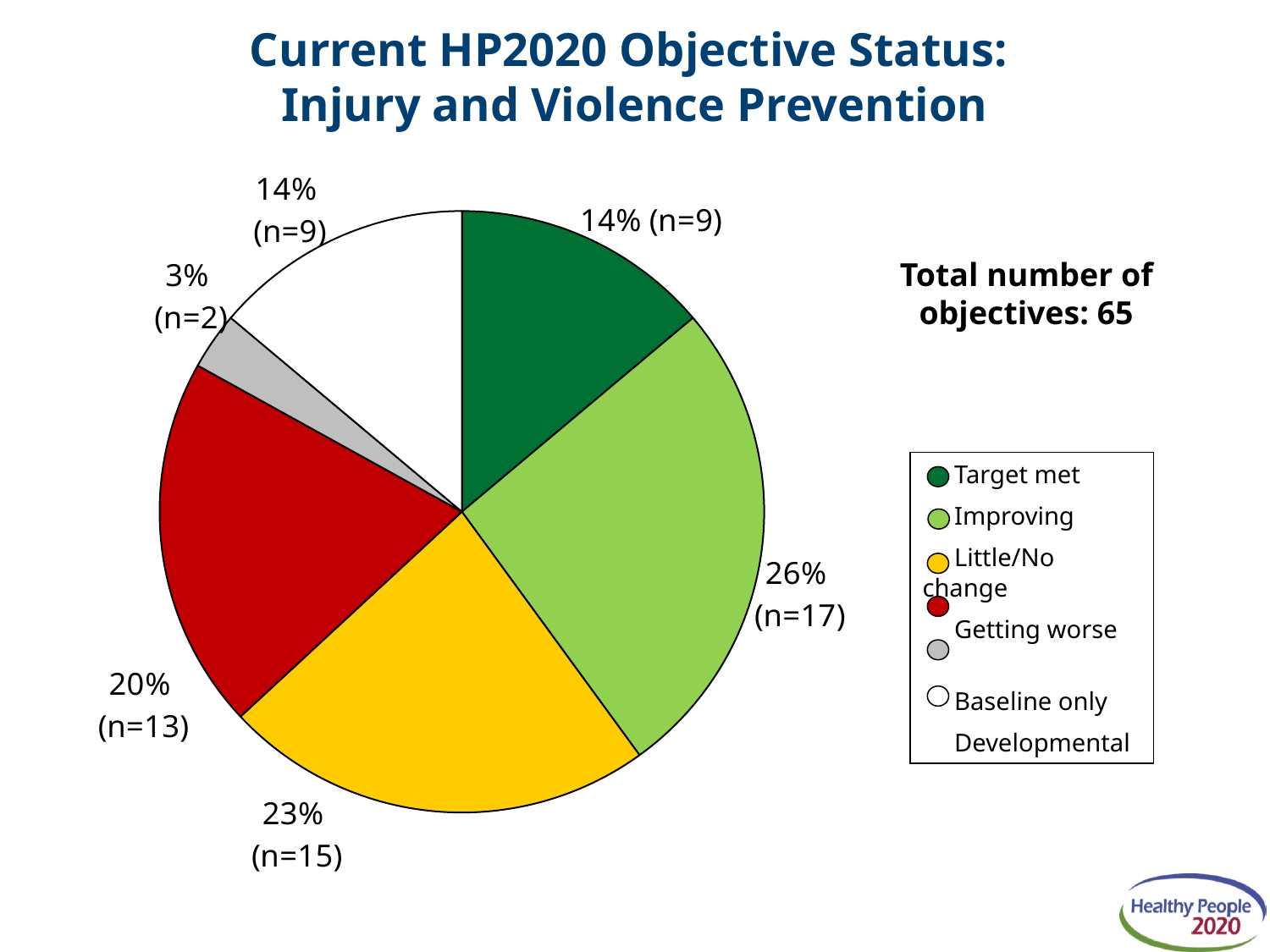
What percentage of objectives are Getting worse? 20% Which has more objectives, Little/No change or Getting worse? Little/No change Which category has the smallest share of objectives? Baseline only How many objectives are in the Little/No change category? 15 What is the total number of objectives shown on the slide? 65 How many more objectives are Improving than Getting worse? 4 How many objectives are Baseline only? 2 What type of chart is shown on the slide? Pie chart What percentage of objectives are in the Improving category? 26% Which category has the largest share of objectives? Improving What colour represents the Getting worse category in the pie chart? Red How many categories does the pie chart have? 6